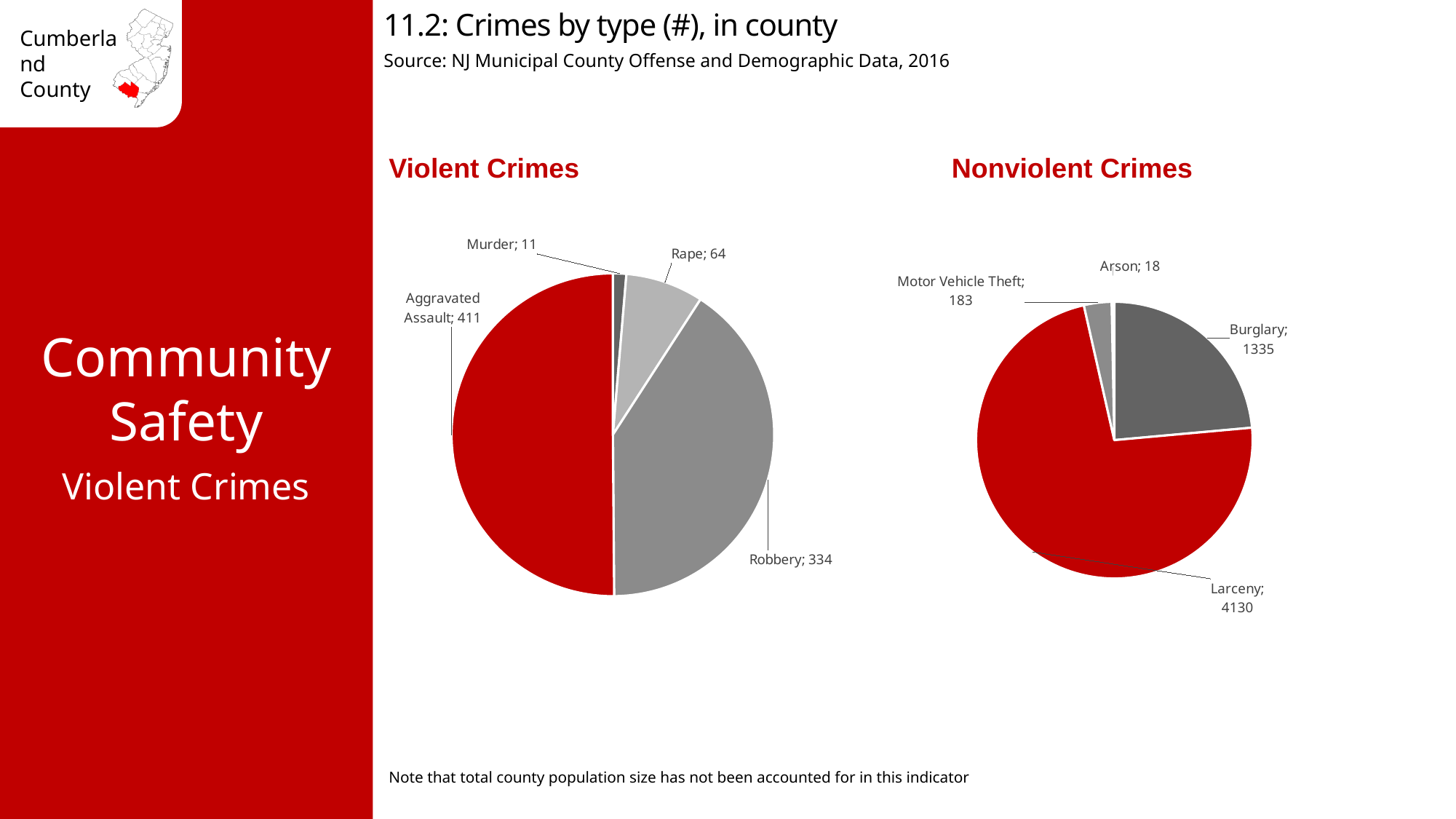
What type of chart is used for Violent Crimes? Pie chart In the Nonviolent Crimes pie chart, which crime type has the largest value? Larceny In the Violent Crimes pie chart, which is larger, Rape or Murder? Rape How many crime types are shown in the Nonviolent Crimes pie chart? 4 In the Violent Crimes pie chart, how many robberies are shown? 334 In the Nonviolent Crimes pie chart, what is the value for Burglary? 1335 In the Violent Crimes pie chart, what is the difference between Aggravated Assault and Robbery? 77 In the Violent Crimes pie chart, what is the value for Aggravated Assault? 411 In the Violent Crimes pie chart, which crime type has the smallest value? Murder In the Nonviolent Crimes pie chart, what is the value for Motor Vehicle Theft? 183 What is the total of all values in the Violent Crimes pie chart? 820 In the Nonviolent Crimes pie chart, what is the difference between Larceny and Burglary? 2795